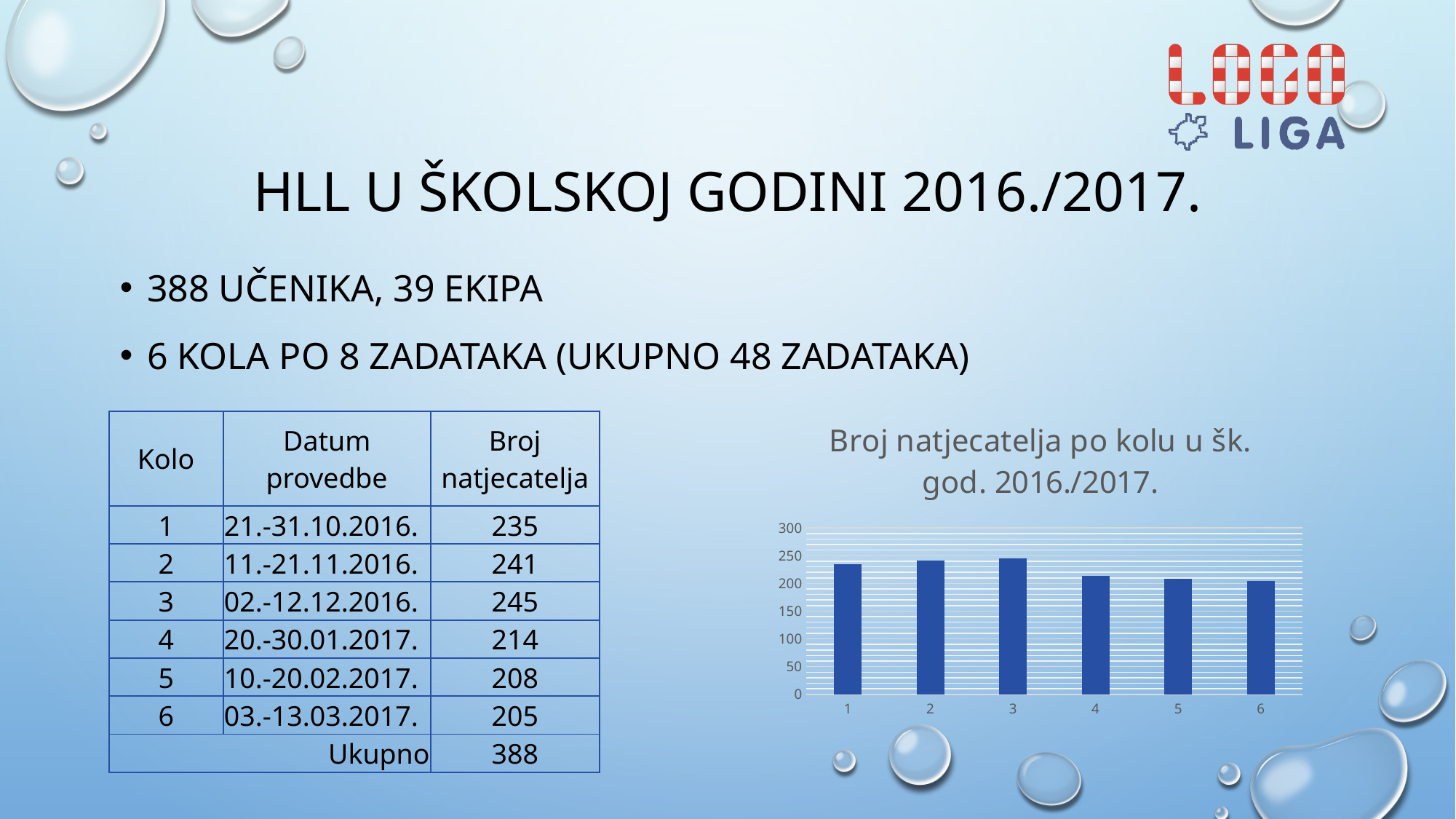
Is the value for kolo 1 greater or less than 200? greater Which kolo has the lowest number of competitors? 6 What kind of chart is shown on the slide? bar chart How many bars (kola) does the chart show? 6 What is the number of competitors for kolo 4? 214 What is the difference between the number of competitors in kolo 3 and kolo 6? 40 What is the title of the chart? Broj natjecatelja po kolu u šk. god. 2016./2017. Is the value for kolo 5 greater or less than 250? less What is the number of competitors (broj natjecatelja) for kolo 1? 235 Which has more competitors, kolo 1 or kolo 4? kolo 1 Do the values rise or fall from kolo 3 to kolo 6? fall Which kolo has the highest number of competitors? 3